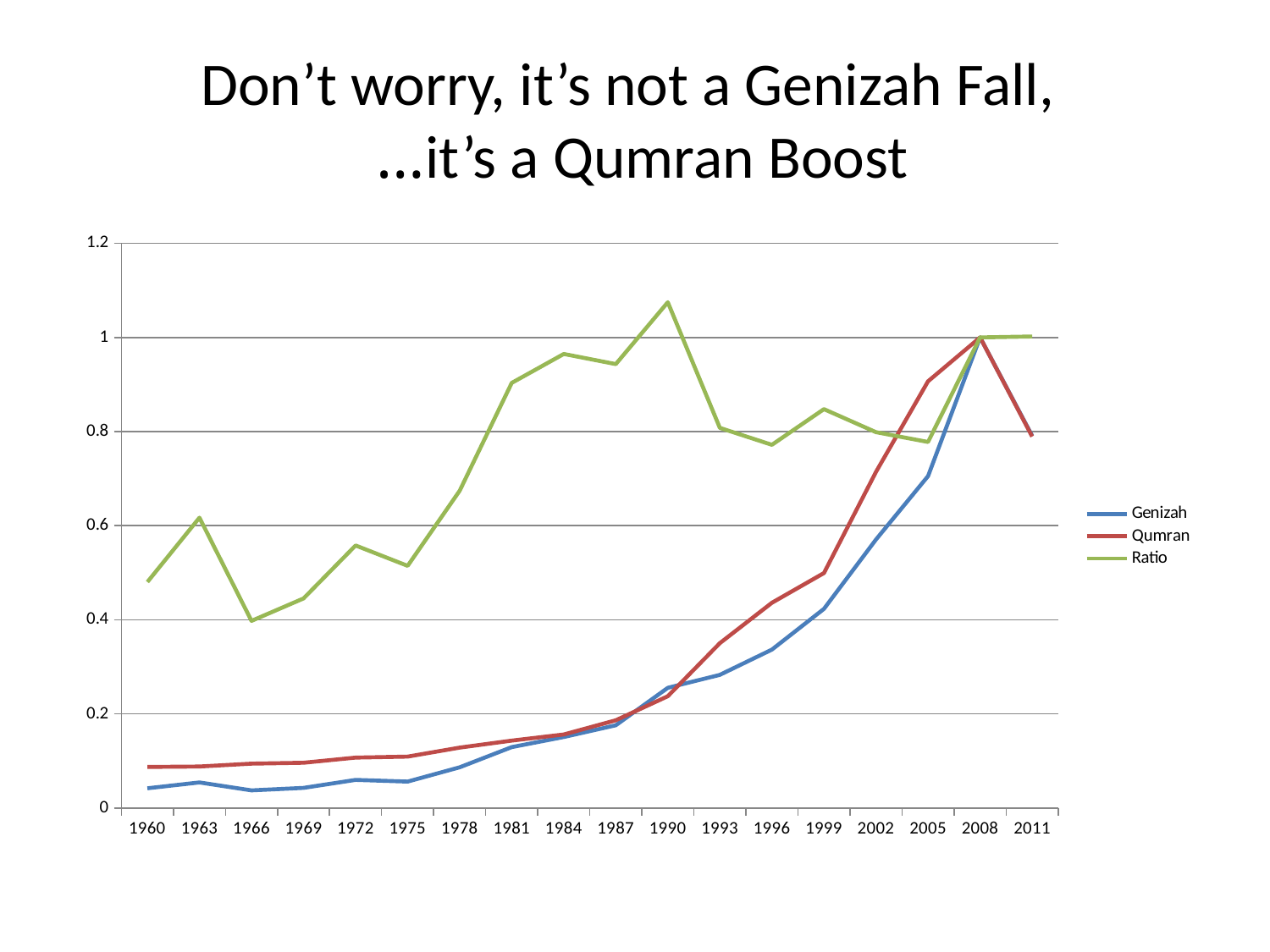
In 1999, which series has the higher value, Qumran or Genizah? Qumran Which series are listed in the legend? Genizah, Qumran, Ratio In 2011, which series has the higher value, Ratio or Qumran? Ratio Is the value for Genizah in 2005 greater or less than 0.6? greater How many series does the legend list? 3 Is the value for Ratio in 1990 greater or less than 1? greater How many years are labelled along the x axis? 18 Is the value for Genizah in 1960 greater or less than 0.2? less In which year is the Ratio series at its lowest? 1966 What kind of chart is shown on the slide? line chart In which year does the Genizah series reach its highest value? 2008 In which year does the Ratio series reach its highest value? 1990